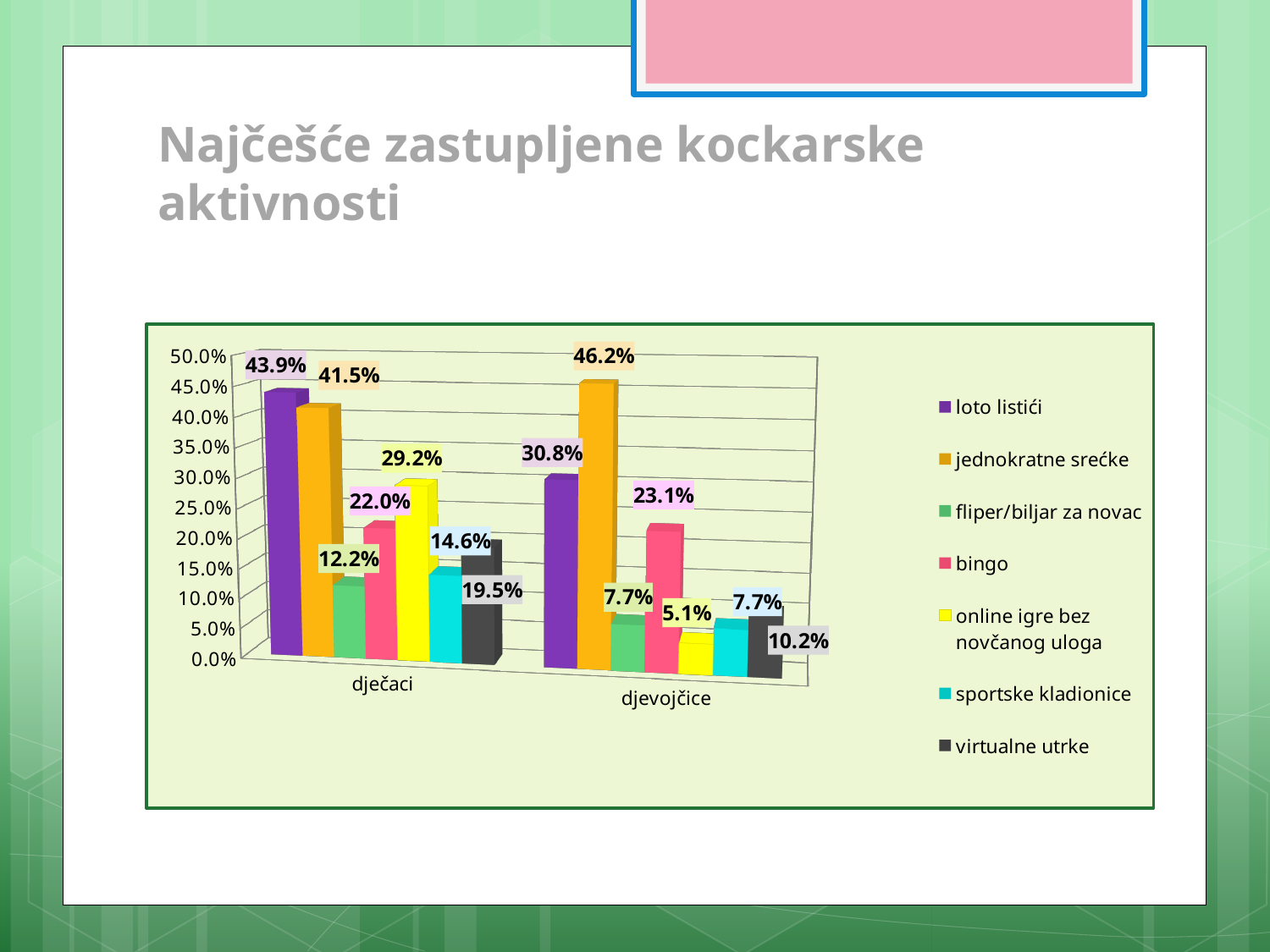
What is the difference between the loto listići values for dječaci and djevojčice? 13.1% Which activity has the highest value among djevojčice? jednokratne srećke What is the value for online igre bez novčanog uloga among dječaci? 29.2% What is the value for jednokratne srećke among djevojčice? 46.2% What kind of chart is shown on the slide? bar chart What is the value for loto listići among dječaci? 43.9% How many categories are shown on the x axis? 2 How many series does the legend list? 7 Which activity has the lowest value among dječaci? fliper/biljar za novac What is the value for virtualne utrke among djevojčice? 10.2% Which activity has the lowest value among djevojčice? online igre bez novčanog uloga Which is larger: bingo for dječaci or bingo for djevojčice? bingo for djevojčice